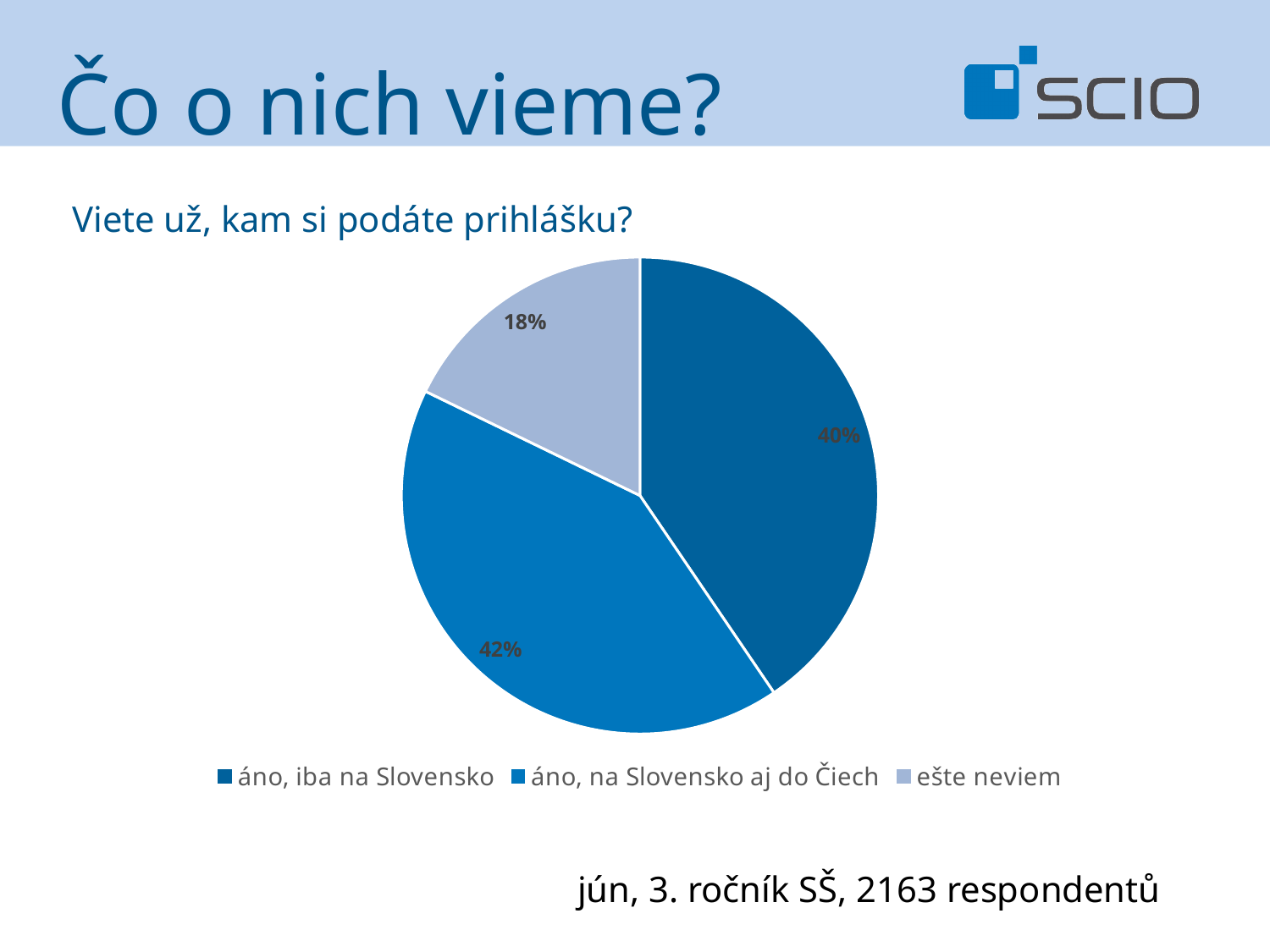
How many respondents does the note below the chart mention? 2163 What question is the pie chart about, according to the text above it? Viete už, kam si podáte prihlášku? Which answer has the smallest share of the pie? ešte neviem How many slices does the pie chart have? 3 How many entries does the legend list? 3 What share of respondents answered "ešte neviem"? 18% What is the difference in percentage points between "áno, na Slovensko aj do Čiech" and "ešte neviem"? 24 percentage points What share of respondents answered "áno, iba na Slovensko"? 40% What kind of chart is shown on the slide? pie chart Which is larger: the share for "áno, iba na Slovensko" or the share for "ešte neviem"? áno, iba na Slovensko What share of respondents answered "áno, na Slovensko aj do Čiech"? 42% Which answer has the largest share of the pie? áno, na Slovensko aj do Čiech